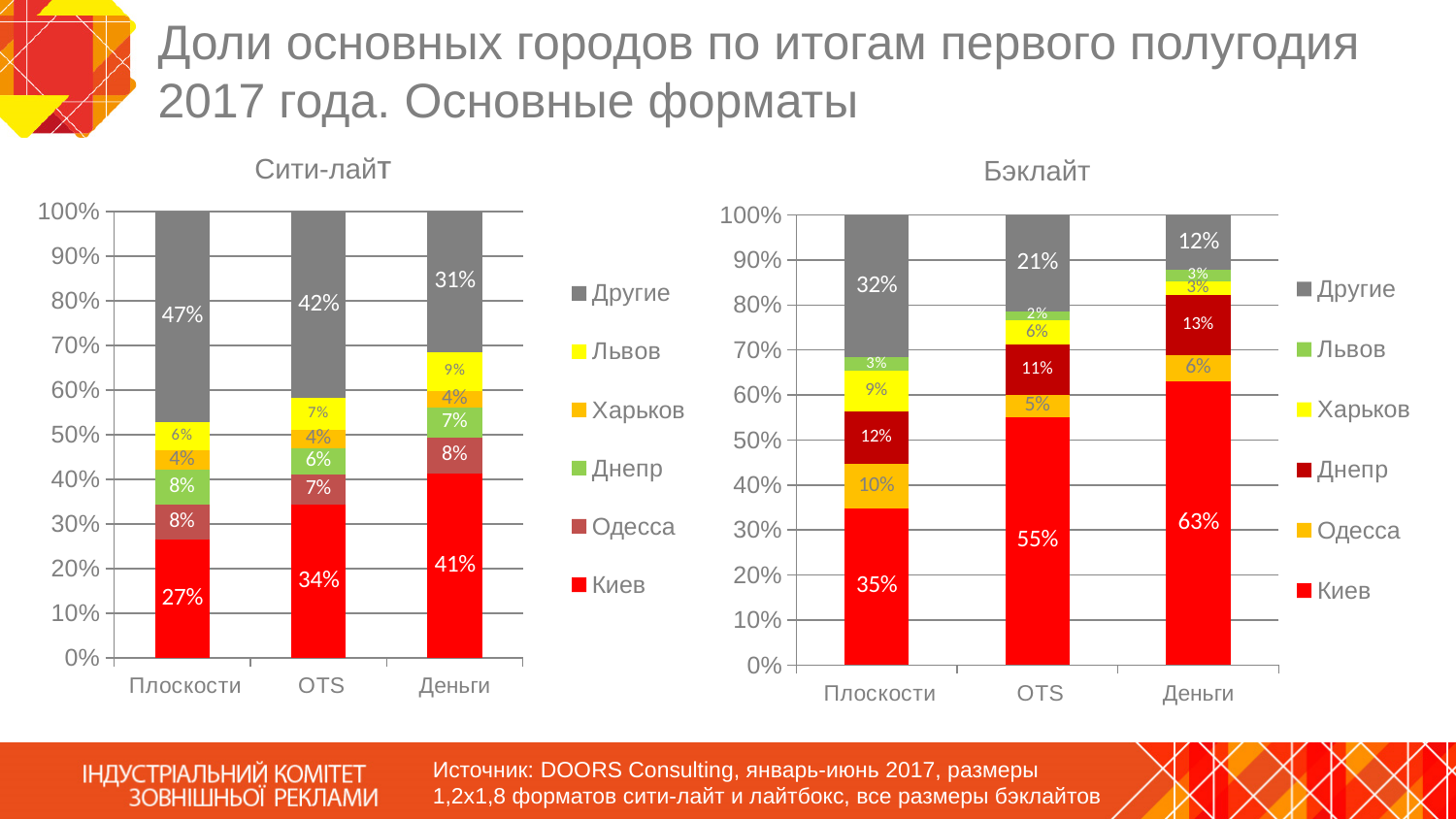
In the Сити-лайт chart, what is the value for Киев in the Плоскости bar? 27% In the Бэклайт chart, does the value for Киев rise or fall from Плоскости to Деньги? Rise What kind of chart is the Бэклайт chart? Stacked bar chart In the Сити-лайт chart, which category has the highest value for Киев? Деньги In the Сити-лайт chart, what is the difference between the Другие values for Плоскости and Деньги? 16% In the Сити-лайт chart, what is the value for Другие in the OTS bar? 42% In the Бэклайт chart, what is the value for Киев in the Деньги bar? 63% In the Бэклайт chart, which category has the lowest value for Другие? Деньги In the Бэклайт chart, which is larger: Киев for OTS or Киев for Плоскости? Киев for OTS How many categories are shown on the x axis of the Бэклайт chart? 3 In the Бэклайт chart, what is the value for Днепр in the Плоскости bar? 12% How many series does the legend of the Сити-лайт chart list? 6